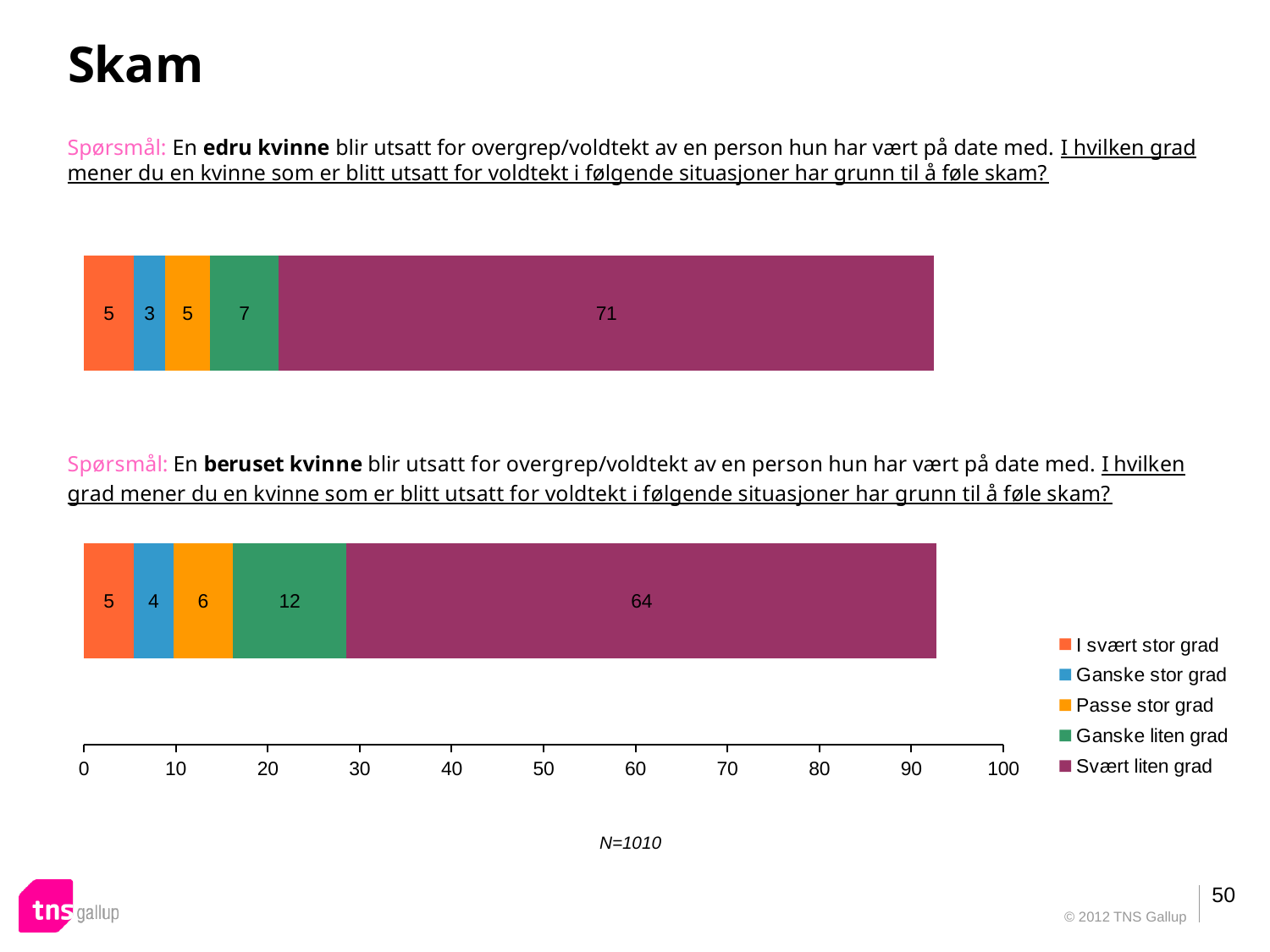
In the top chart (edru kvinne), what is the value for 'Ganske stor grad'? 3 In the top chart (edru kvinne), what is the value for 'Svært liten grad'? 71 In the top chart (edru kvinne), which category has the lowest value? Ganske stor grad What type of chart is used on this slide? Stacked bar chart What is the total of the stacked bar in the bottom chart (beruset kvinne)? 91 What is the difference between the 'Svært liten grad' value in the top chart (edru kvinne) and in the bottom chart (beruset kvinne)? 7 In the top chart (edru kvinne), which category has the highest value? Svært liten grad In the bottom chart (beruset kvinne), what is the value for 'Passe stor grad'? 6 How many series does the legend list? 5 Which colour represents 'Svært liten grad' in the legend? Purple In the bottom chart (beruset kvinne), what is the value for 'Ganske liten grad'? 12 Which is larger: 'Ganske liten grad' in the top chart (edru kvinne) or in the bottom chart (beruset kvinne)? Bottom chart (beruset kvinne)